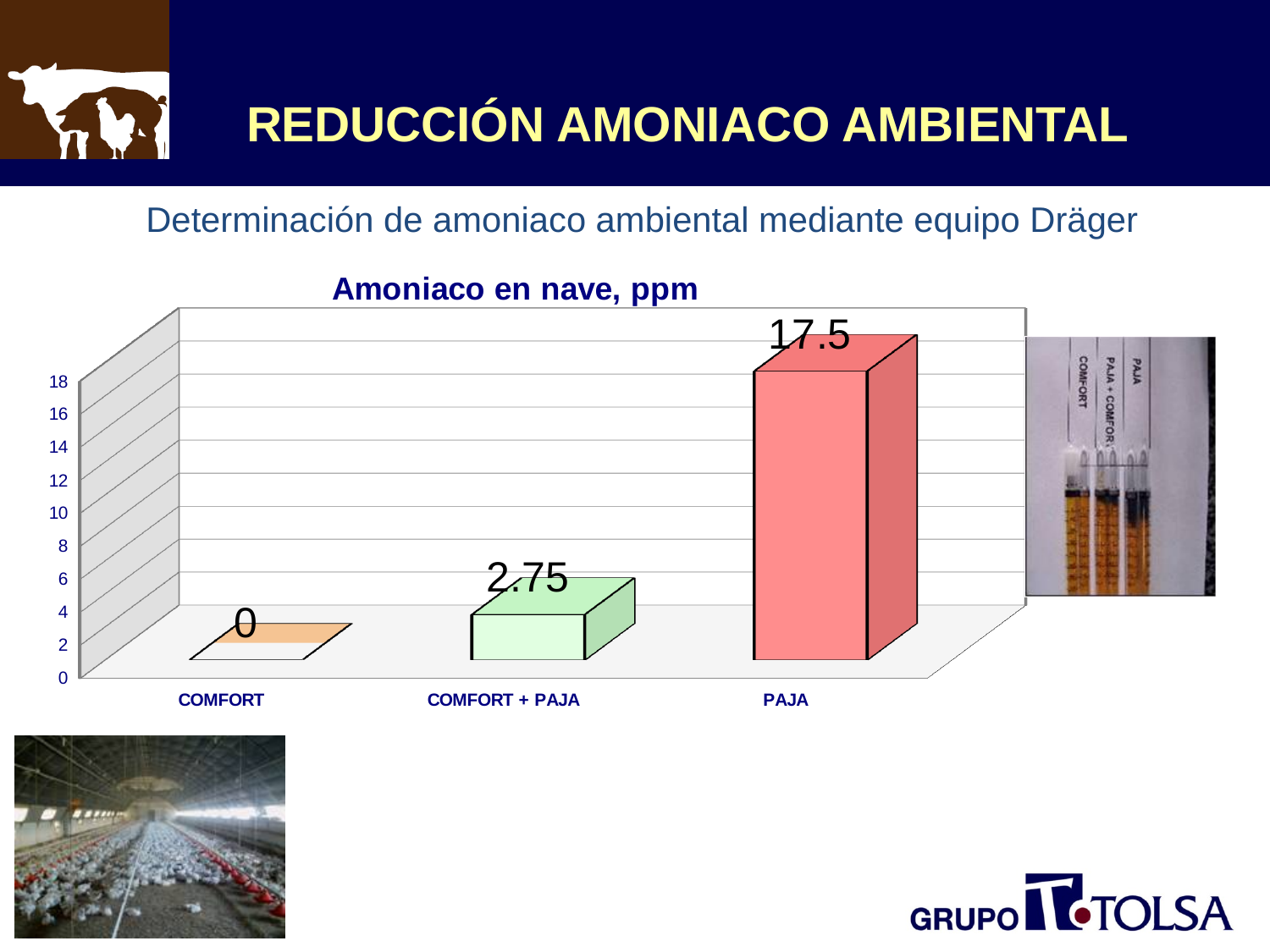
What is the value for PAJA in the chart? 17.5 What is the value for COMFORT in the chart? 0 What is the value for COMFORT + PAJA in the chart? 2.75 Which category has the lowest value? COMFORT Which category has the highest value? PAJA Which is larger, the value for COMFORT + PAJA or the value for PAJA? PAJA What is the title of the chart? Amoniaco en nave, ppm Is the value for PAJA greater or less than 16? greater What is the difference between the values for PAJA and COMFORT + PAJA? 14.75 Do the values rise or fall from left to right along the x axis? rise How many categories are shown on the x axis of the chart? 3 What kind of chart is shown on the slide? bar chart